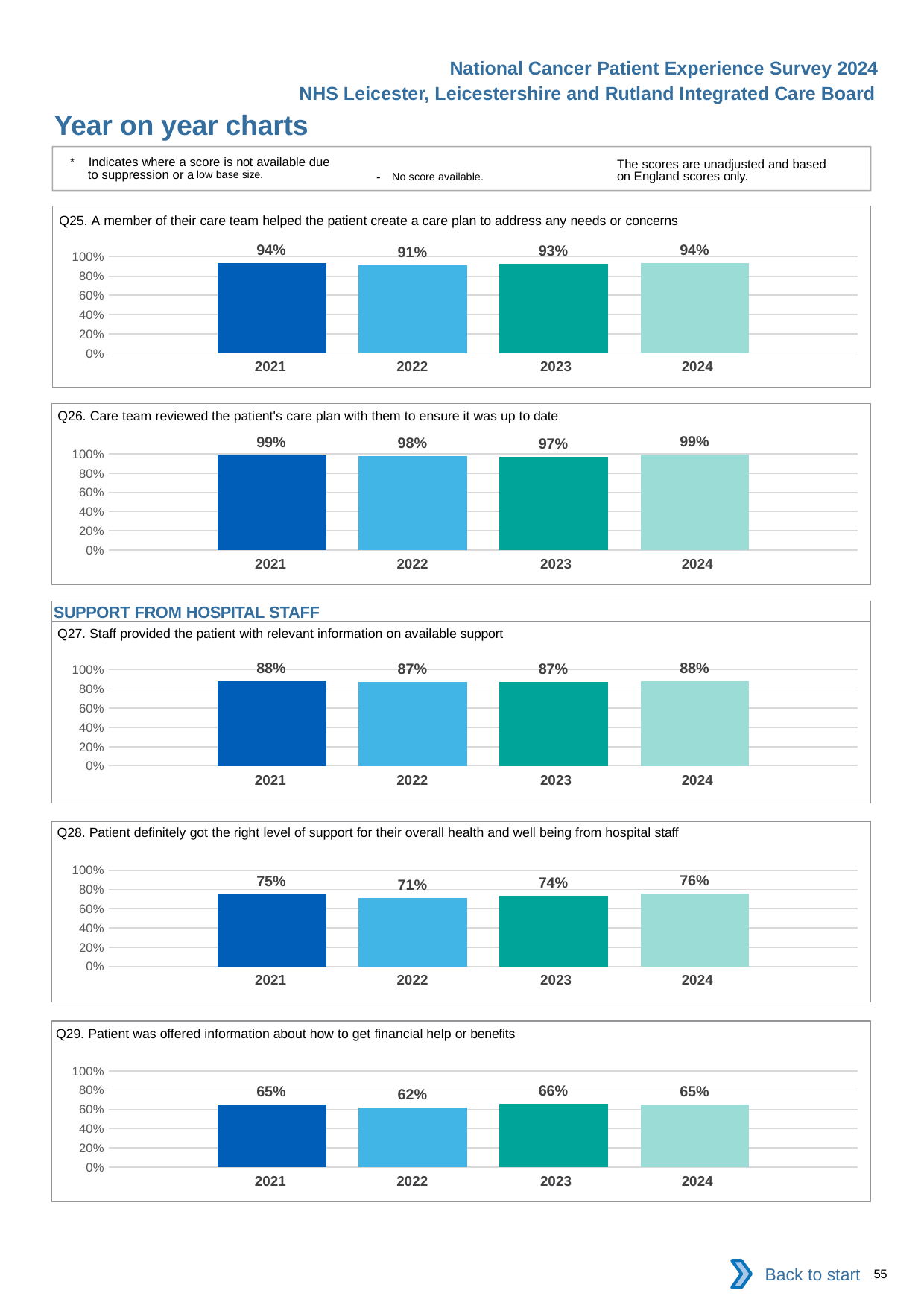
In the Q25 chart, what is the value for 2022? 91% In the Q29 chart, what is the difference between the 2023 and 2022 values? 4% In the Q28 chart, is the value for 2021 greater or less than 60%? greater What is the section heading shown above the Q27 chart? SUPPORT FROM HOSPITAL STAFF In the Q27 chart, what is the difference between the 2021 and 2022 values? 1% In the Q26 chart, which year has the lowest value? 2023 In the Q28 chart, which year has the highest value? 2024 In the Q26 chart, what is the value for 2024? 99% In the Q28 chart, is the value for 2022 larger or smaller than the value for 2023? smaller What kind of chart is the Q26 chart? bar chart How many years are shown in the Q25 chart? 4 In the Q29 chart, what is the value for 2023? 66%